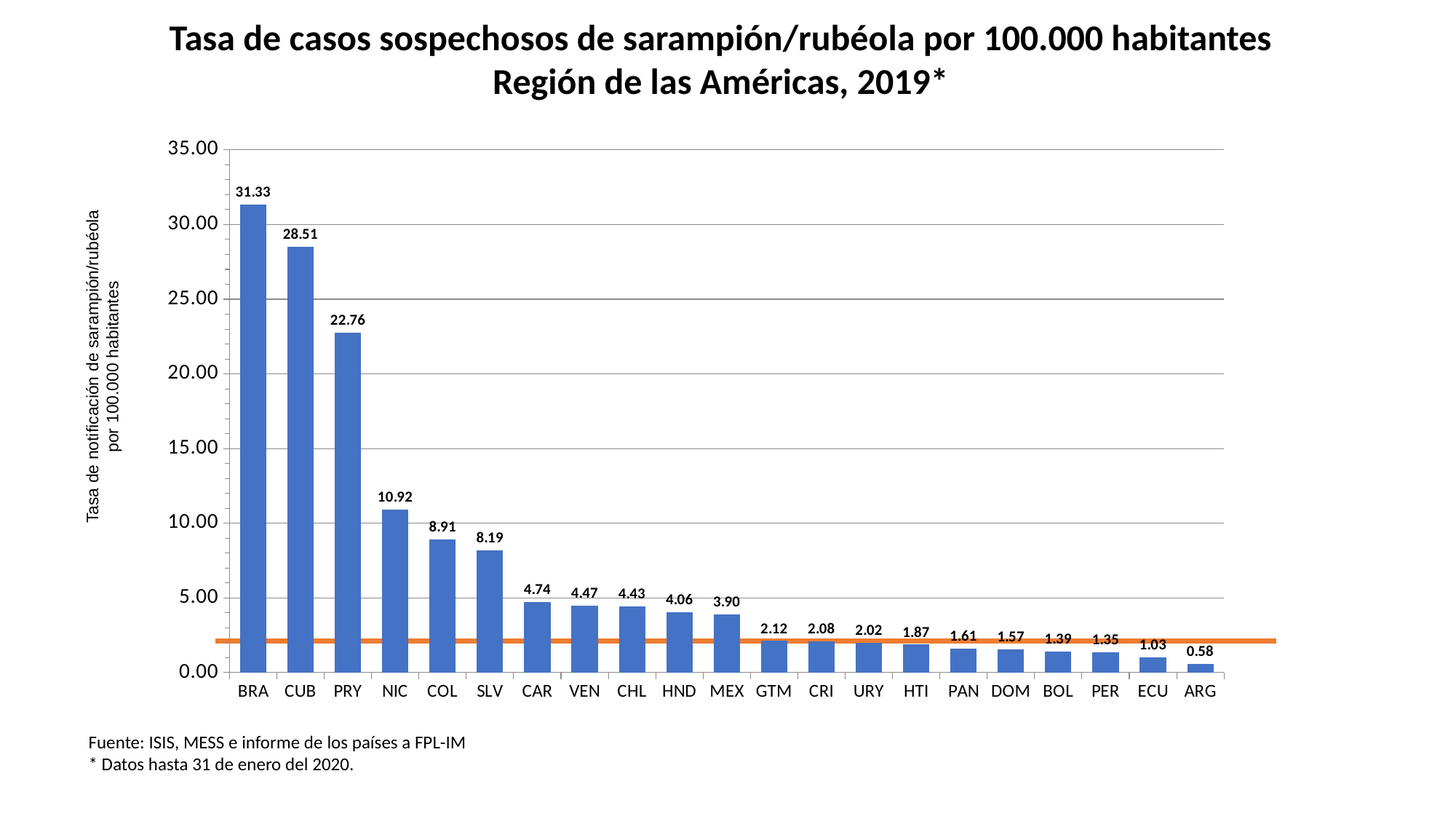
Which country has the highest rate? BRA Do the values rise or fall from left to right along the x axis? fall What is the value for ECU? 1.03 Which country has the lowest rate? ARG What is the difference between the values for BRA and CUB? 2.82 What is the value for BRA? 31.33 What is the value for MEX? 3.90 Is the value for COL greater or less than 10.00? less Which is larger, the value for PRY or the value for NIC? PRY What kind of chart is this? bar chart How many countries are shown on the x axis? 21 What is the value for NIC? 10.92